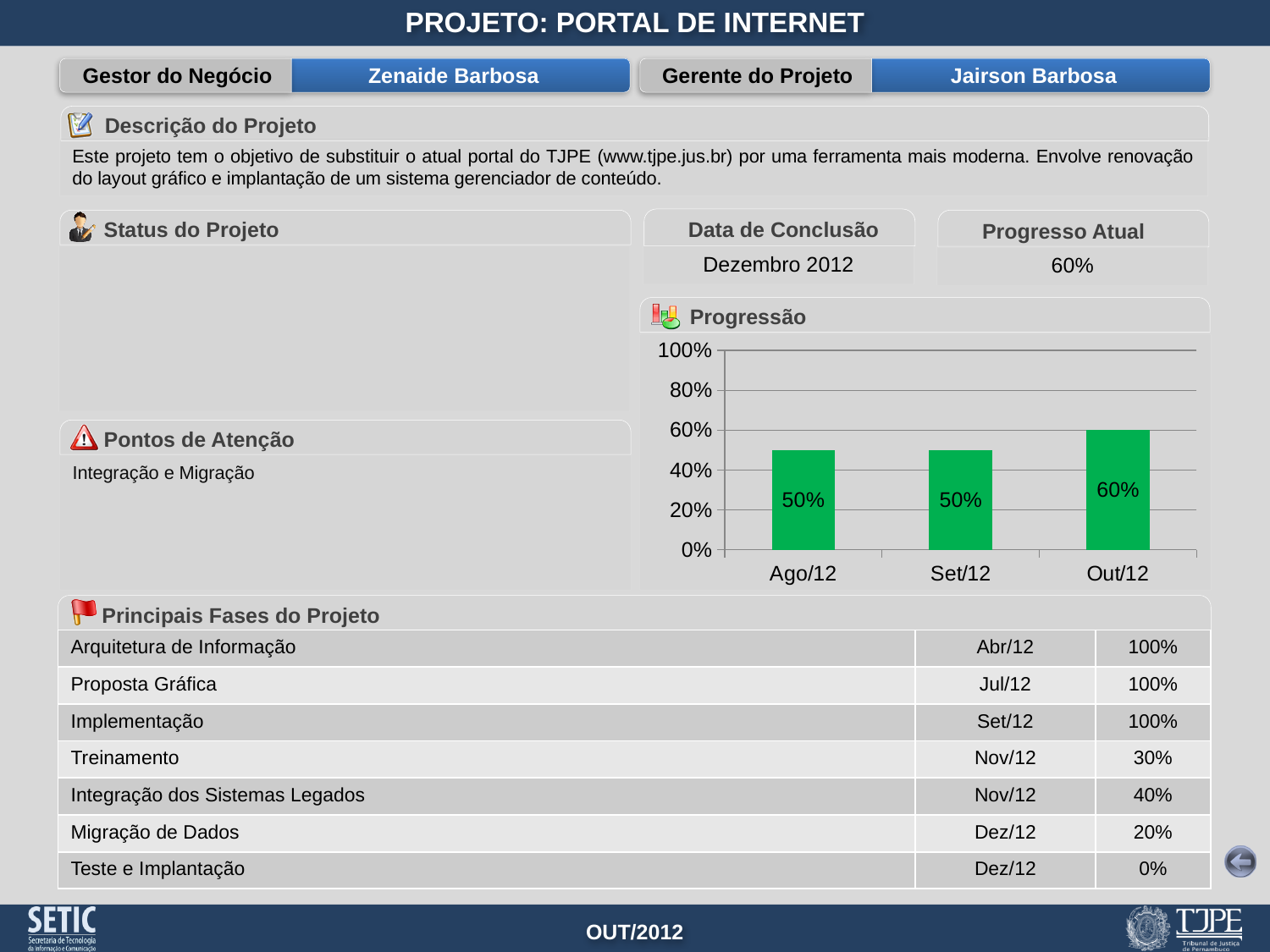
How many months are shown on the x axis of the Progressão chart? 3 What is the title of the chart on the slide? Progressão What is the difference between the values for Out/12 and Set/12 in the Progressão chart? 10% Is the value for Ago/12 in the Progressão chart greater or less than 80%? less What is the value for Set/12 in the Progressão chart? 50% Is the value for Out/12 in the Progressão chart greater or less than 40%? greater Which is larger in the Progressão chart, the value for Ago/12 or Out/12? Out/12 What kind of chart is the Progressão chart? bar chart What is the value for Out/12 in the Progressão chart? 60% What is the value for Ago/12 in the Progressão chart? 50% Which month has the highest value in the Progressão chart? Out/12 Do the values in the Progressão chart rise or fall from Ago/12 to Out/12? rise